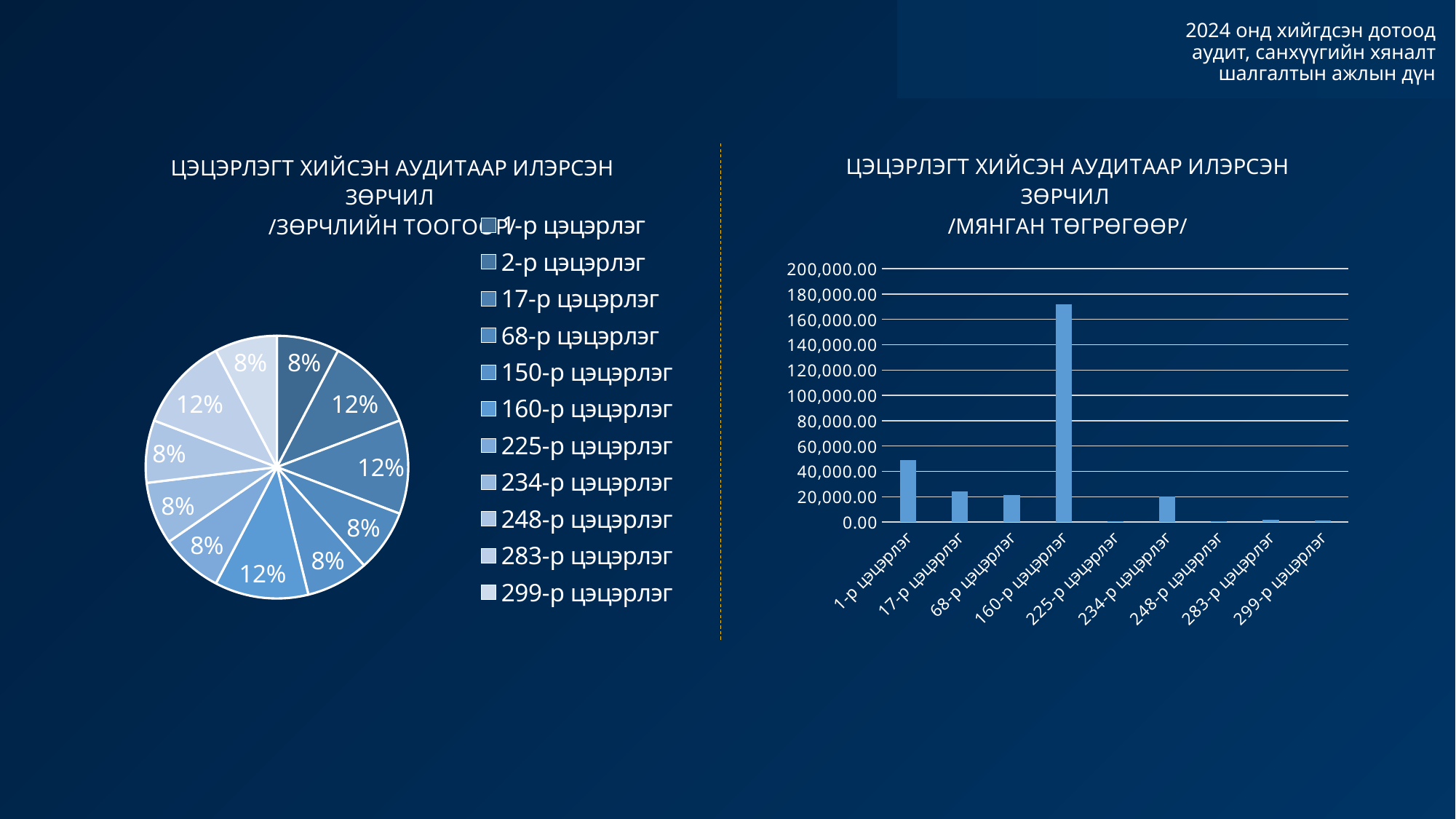
In the bar chart on the right, is the value for 1-р цэцэрлэг greater or less than 40,000.00? greater In the bar chart on the right, is the value for 17-р цэцэрлэг greater or less than 40,000.00? less How many entries does the legend of the pie chart on the left list? 11 How many categories are shown on the x axis of the bar chart on the right? 9 In the pie chart on the left, what share is labelled for the 1-р цэцэрлэг slice? 8% In the bar chart on the right, which category has the highest value? 160-р цэцэрлэг What kind of chart is the chart on the left of the slide? pie chart In the bar chart on the right, is the value for 160-р цэцэрлэг greater or less than 160,000.00? greater In the bar chart on the right, which is larger: the value for 1-р цэцэрлэг or the value for 68-р цэцэрлэг? 1-р цэцэрлэг What is the highest value shown on the y axis of the bar chart on the right? 200,000.00 In the pie chart on the left, what share is labelled for the 2-р цэцэрлэг slice? 12% What kind of chart is the chart on the right of the slide (/МЯНГАН ТӨГРӨГӨӨР/)? bar chart